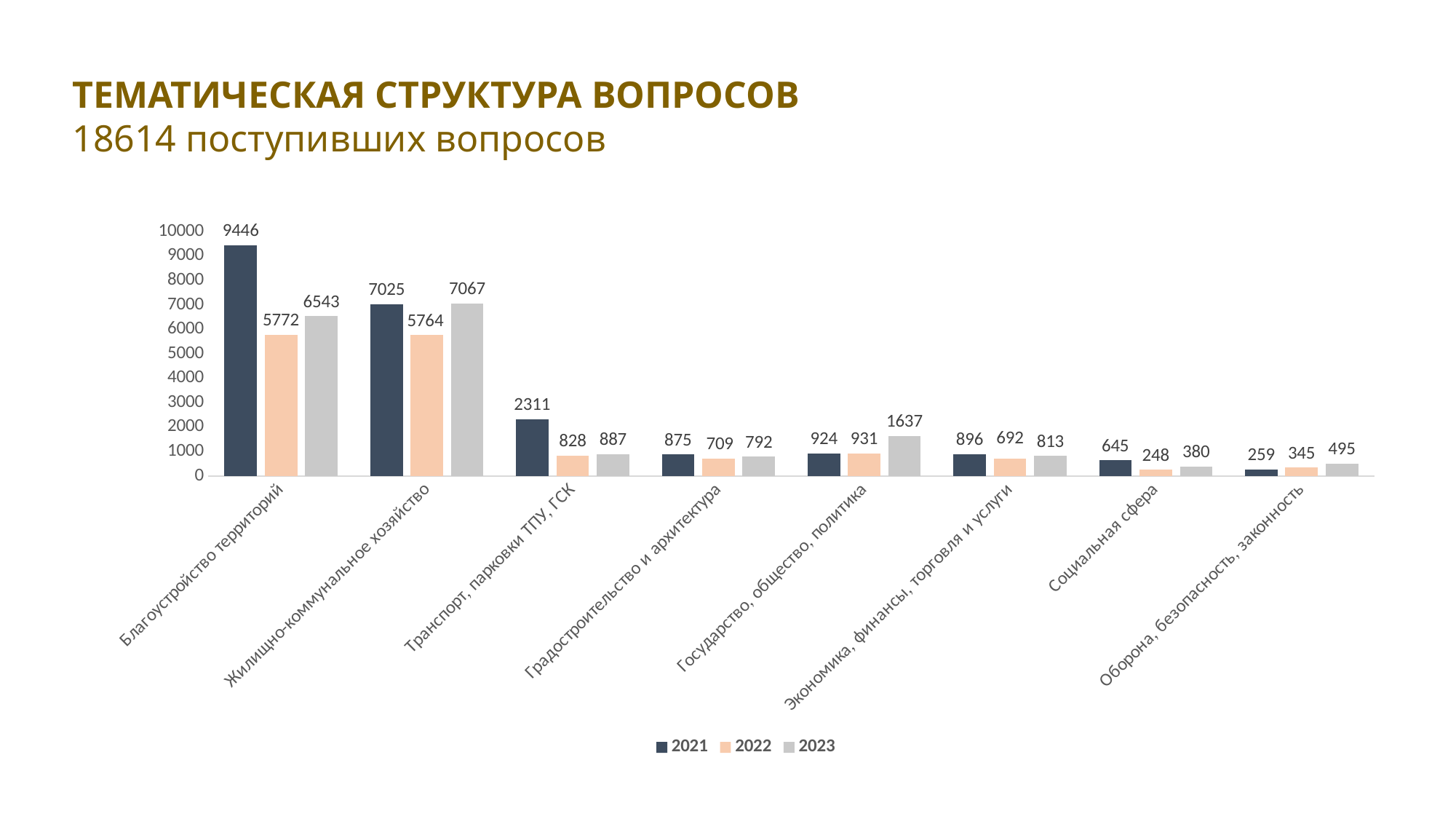
What is the value for Благоустройство территорий in 2021? 9446 Which category has the highest value in 2021? Благоустройство территорий How many categories are shown on the x axis? 8 How many series does the legend list? 3 What is the value for Государство, общество, политика in 2023? 1637 What is the value for Жилищно-коммунальное хозяйство in 2023? 7067 What is the difference between the 2021 and 2022 values for Транспорт, парковки ТПУ, ГСК? 1483 What is the total number of questions stated in the slide subtitle? 18614 Which category has the lowest value in 2022? Социальная сфера What is the value for Социальная сфера in 2022? 248 What kind of chart is shown on the slide? bar chart Which is larger for Оборона, безопасность, законность: the 2021 value or the 2023 value? 2023